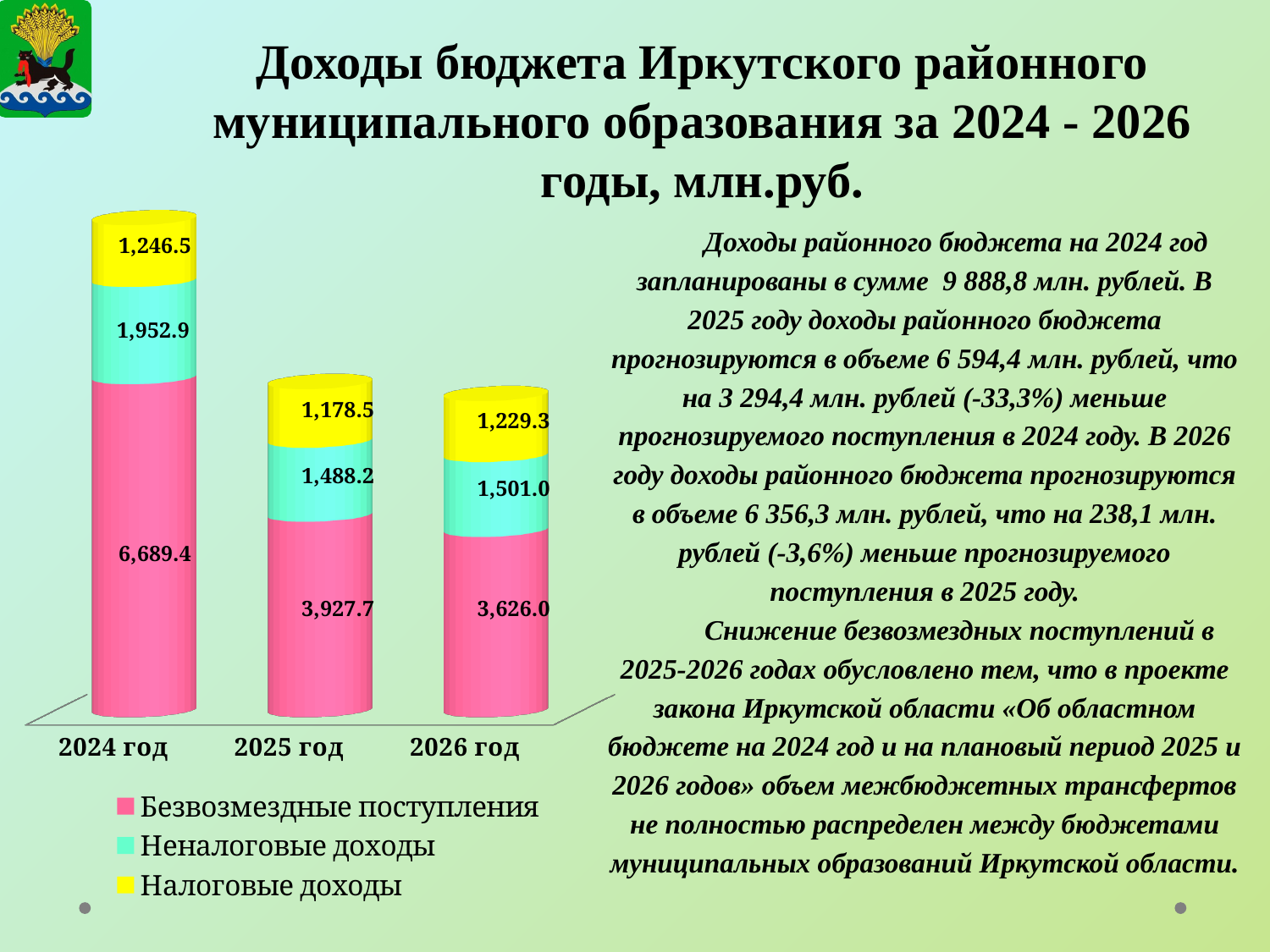
Which series is shown in yellow in the legend? Налоговые доходы Which is larger: Неналоговые доходы in 2025 год or in 2026 год? 2026 год What is the value of Налоговые доходы for 2025 год? 1,178.5 How many years (categories) are shown on the x axis? 3 How many series does the legend list? 3 What is the value of Неналоговые доходы for 2026 год? 1,501.0 What is the value of Безвозмездные поступления for 2024 год? 6,689.4 What type of chart is shown on the slide? Stacked bar chart In which year is the value of Налоговые доходы the lowest? 2025 год In which year is the value of Безвозмездные поступления the highest? 2024 год What is the difference between Безвозмездные поступления in 2024 год and 2025 год? 2,761.7 What is the total of the stacked bar for 2025 год? 6,594.4